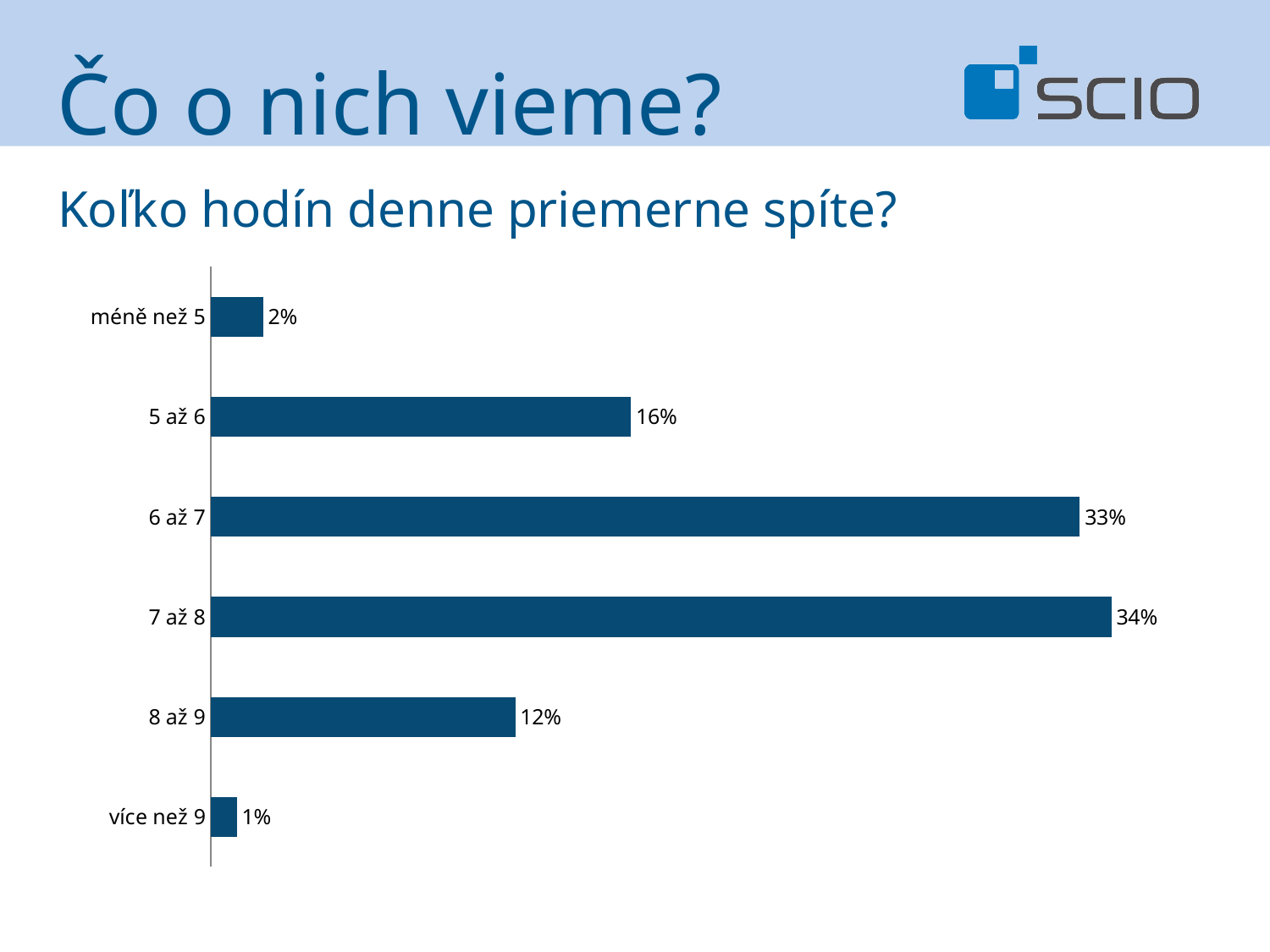
What is the value for the "více než 9" category? 1% What is the value for the "8 až 9" category? 12% What is the difference between the values for "8 až 9" and "méně než 5"? 10% What is the difference between the values for "6 až 7" and "5 až 6"? 17% How many categories are shown in the chart? 6 Which category has the lowest value? více než 9 What is the value for the "5 až 6" category? 16% Which category has the highest value? 7 až 8 What is the value for the "6 až 7" category? 33% What kind of chart is shown on the slide? bar chart Which is larger, the value for "5 až 6" or the value for "8 až 9"? 5 až 6 What question does the chart's heading ask? Koľko hodín denne priemerne spíte?